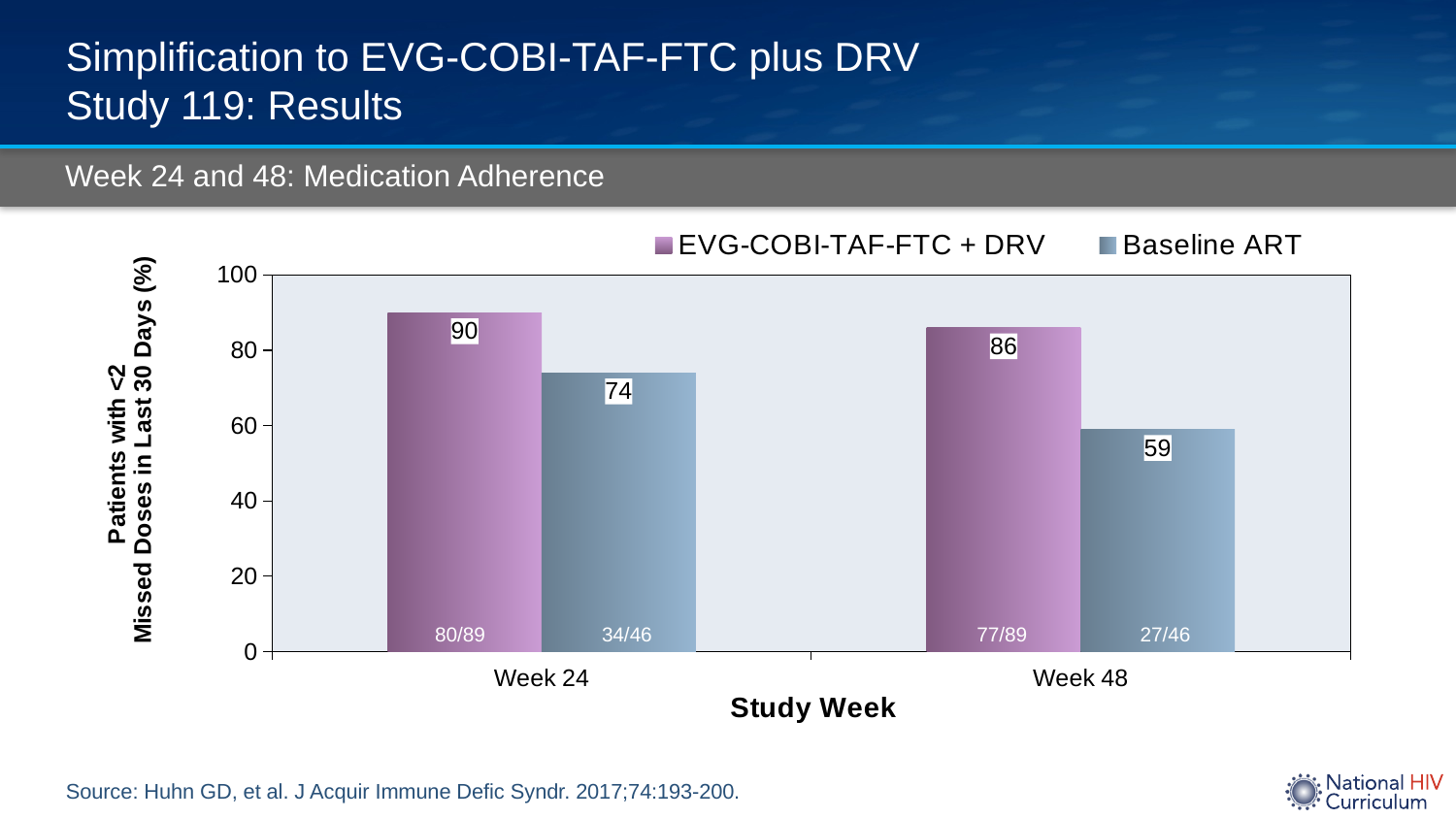
How many study week categories are shown on the x axis? 2 What is the value for Baseline ART at Week 24? 74 What is the value for EVG-COBI-TAF-FTC + DRV at Week 24? 90 Does the Baseline ART value rise or fall from Week 24 to Week 48? Fall What is the value for Baseline ART at Week 48? 59 Which bar has the lowest value on the chart? Baseline ART at Week 48 What is the difference between the EVG-COBI-TAF-FTC + DRV and Baseline ART values at Week 24? 16 How many series does the legend list? 2 What kind of chart is shown on the slide? Bar chart What is the value for EVG-COBI-TAF-FTC + DRV at Week 48? 86 Which is larger: Baseline ART at Week 24 or Baseline ART at Week 48? Baseline ART at Week 24 Which series has the highest value at Week 48? EVG-COBI-TAF-FTC + DRV